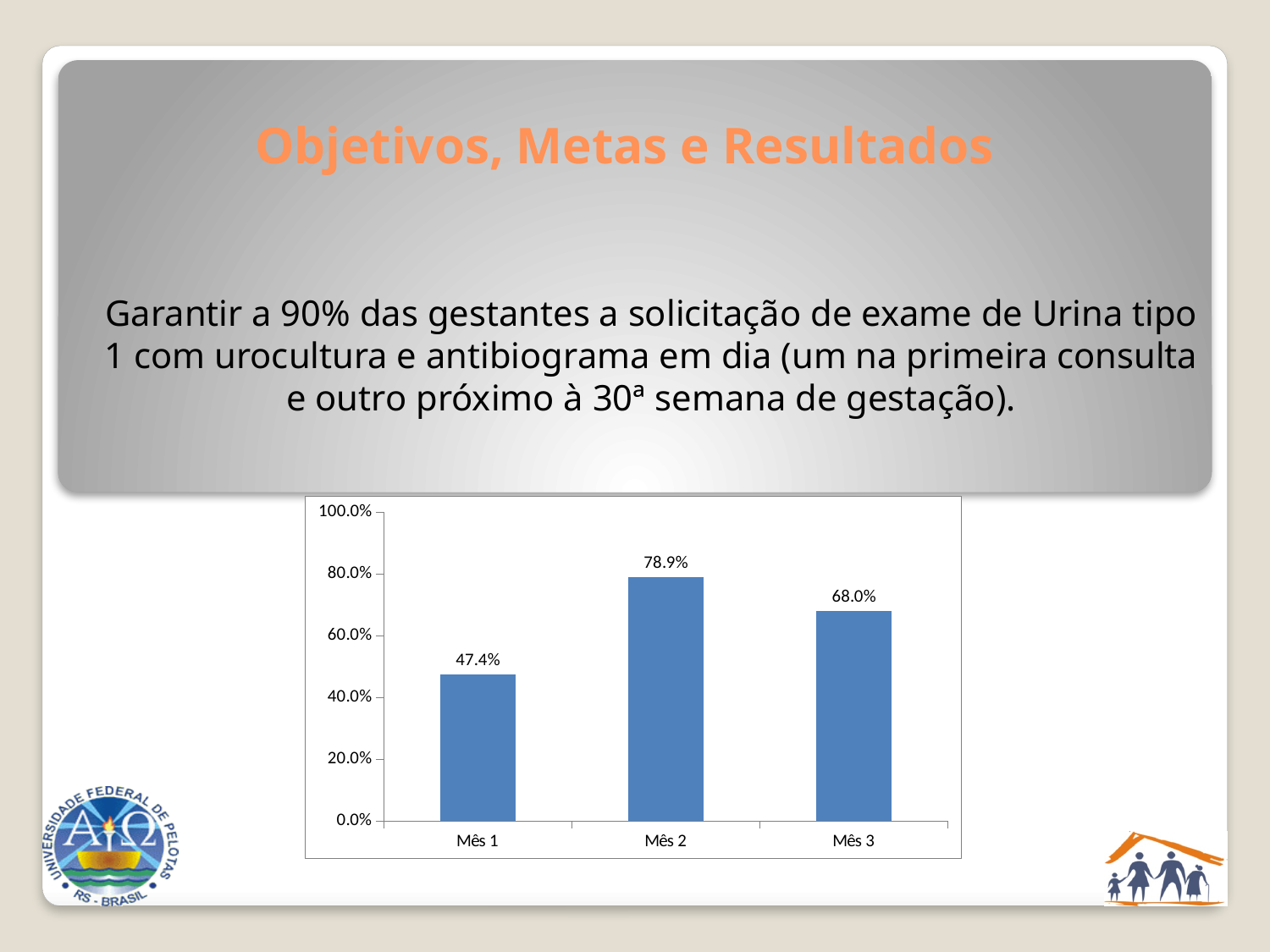
What is the highest tick value shown on the y axis? 100.0% Which month has the highest value? Mês 2 How many categories are shown on the x axis? 3 Which month has the lowest value? Mês 1 What kind of chart is shown on the slide? bar chart What is the difference between the values for Mês 2 and Mês 3? 10.9% Which is larger, the value for Mês 3 or the value for Mês 1? Mês 3 What is the value for Mês 1? 47.4% What is the value for Mês 2? 78.9% What is the difference between the values for Mês 2 and Mês 1? 31.5% Is the value for Mês 1 greater or less than 60.0%? less What is the value for Mês 3? 68.0%